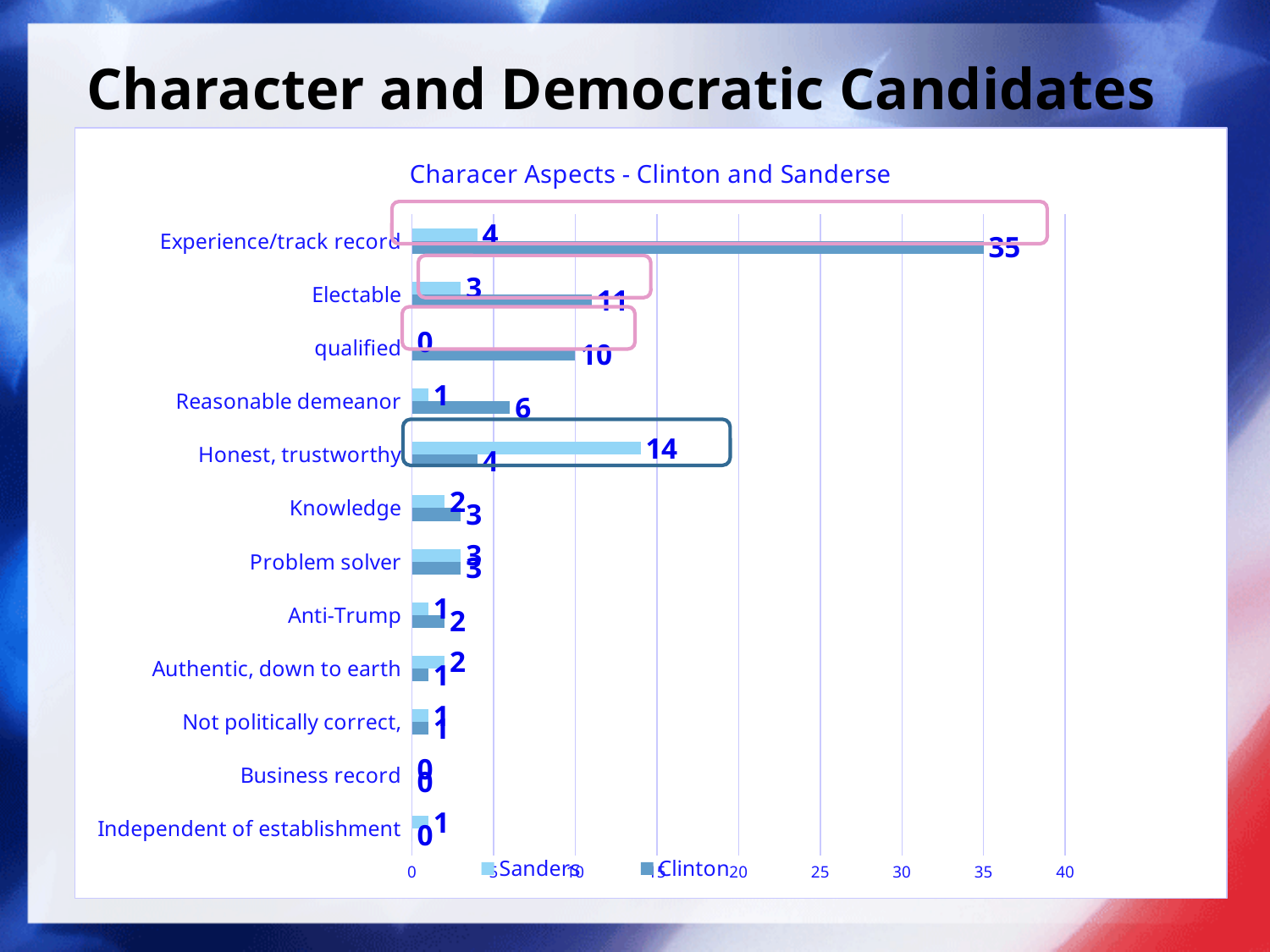
What is the Clinton value for Electable? 11 For Honest, trustworthy, which is larger: the Sanders value or the Clinton value? Sanders What is the title of the chart? Characer Aspects - Clinton and Sanderse How many categories are shown on the chart? 12 Which category has the highest Clinton value? Experience/track record What is the Clinton value for Experience/track record? 35 How many series does the legend list? 2 What type of chart is shown on the slide? bar chart What is the Sanders value for qualified? 0 What is the difference between the Clinton and Sanders values for Experience/track record? 31 Which category has the highest Sanders value? Honest, trustworthy What is the Sanders value for Honest, trustworthy? 14